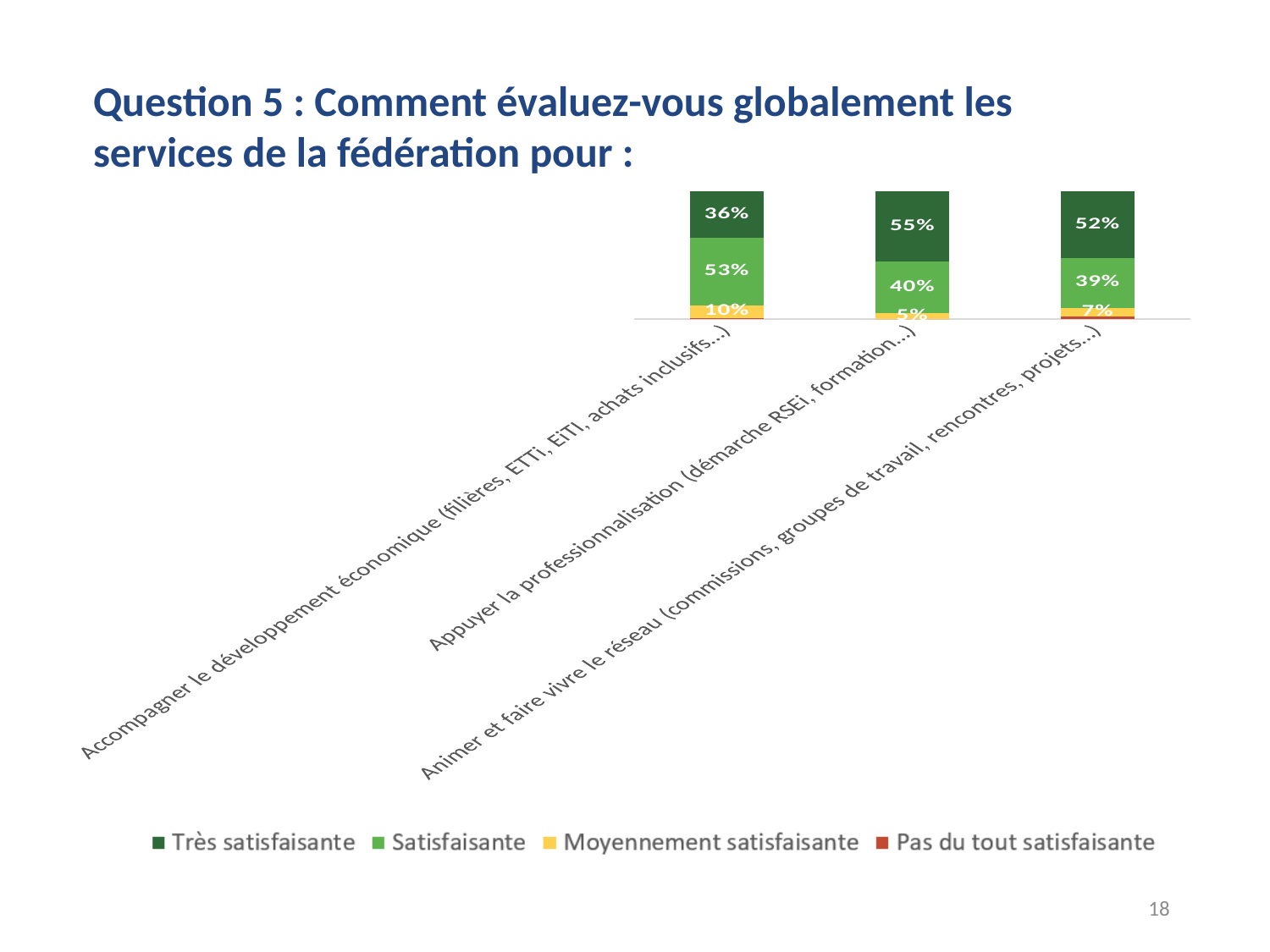
What is the difference between the 'Très satisfaisante' values for 'Appuyer la professionnalisation' and 'Animer et faire vivre le réseau'? 3% What kind of chart is shown on the slide? Stacked bar chart What is the 'Moyennement satisfaisante' value for 'Animer et faire vivre le réseau (commissions, groupes de travail, rencontres, projets...)'? 7% How many categories are plotted along the x axis? 3 What is the 'Satisfaisante' value for 'Appuyer la professionnalisation (démarche RSEi, formation...)'? 40% What is the difference between the 'Satisfaisante' value for 'Accompagner le développement économique' and that for 'Animer et faire vivre le réseau'? 14% How many series does the legend list? 4 Which is larger for 'Accompagner le développement économique': the 'Très satisfaisante' value or the 'Satisfaisante' value? Satisfaisante What is the 'Très satisfaisante' value for 'Accompagner le développement économique (filières, ETTi, EiTI, achats inclusifs...)'? 36% Which legend entry is shown in red? Pas du tout satisfaisante Which category has the lowest 'Moyennement satisfaisante' value? Appuyer la professionnalisation (démarche RSEi, formation...) Which category has the highest 'Très satisfaisante' value? Appuyer la professionnalisation (démarche RSEi, formation...)